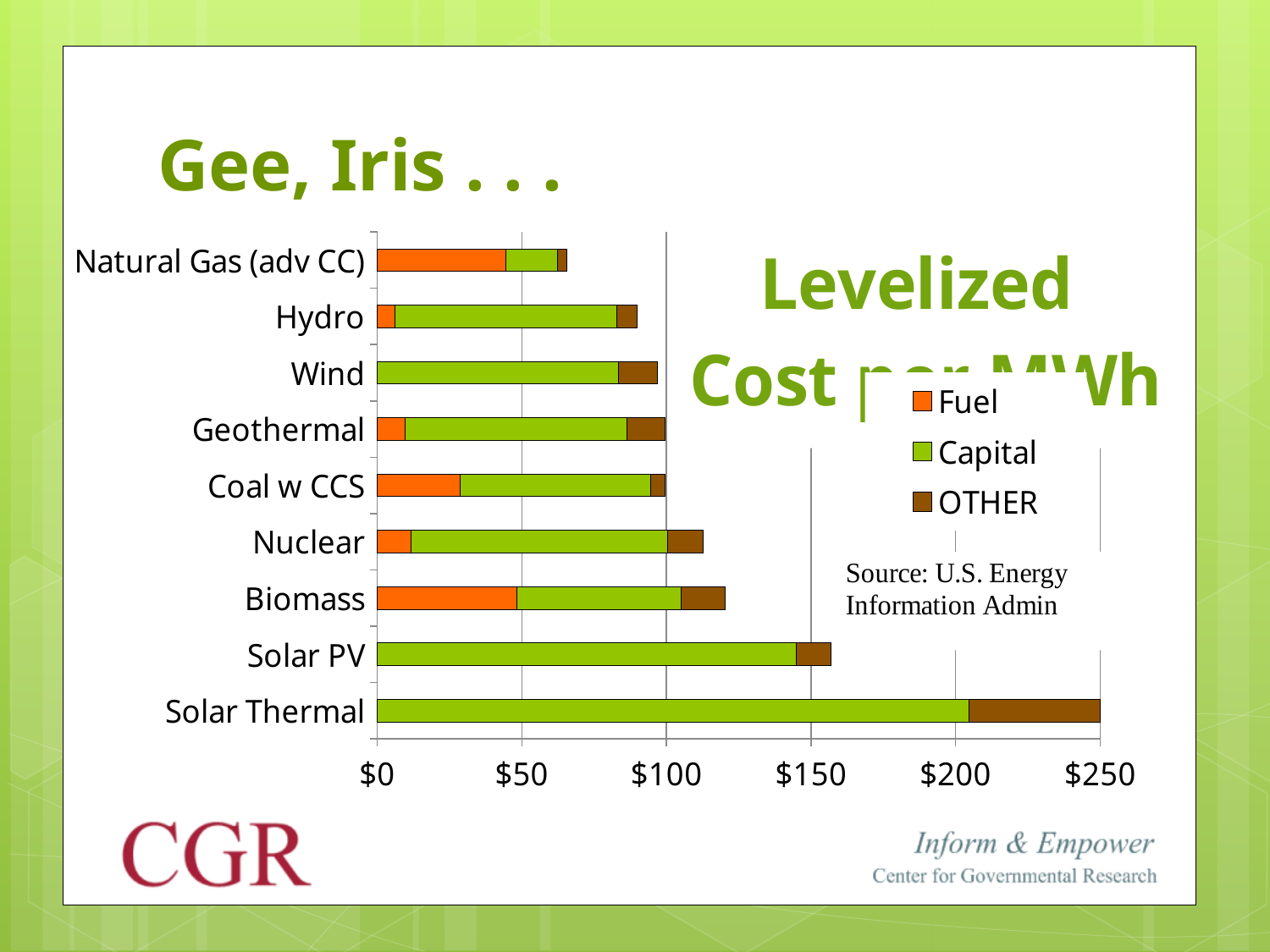
How many energy categories are plotted in the chart? 9 Which has the larger total levelized cost, Nuclear or Hydro? Nuclear How many series does the chart legend list? 3 What kind of chart is shown on the slide? stacked bar chart Which category has the lowest total levelized cost? Natural Gas (adv CC) Is the total value for Nuclear greater or less than $100? greater Is the total value for Hydro greater or less than $100? less Which has the larger total levelized cost, Solar PV or Biomass? Solar PV Is the total value for Natural Gas (adv CC) greater or less than $100? less What are the three series named in the chart legend? Fuel, Capital, OTHER Which category has the highest total levelized cost? Solar Thermal